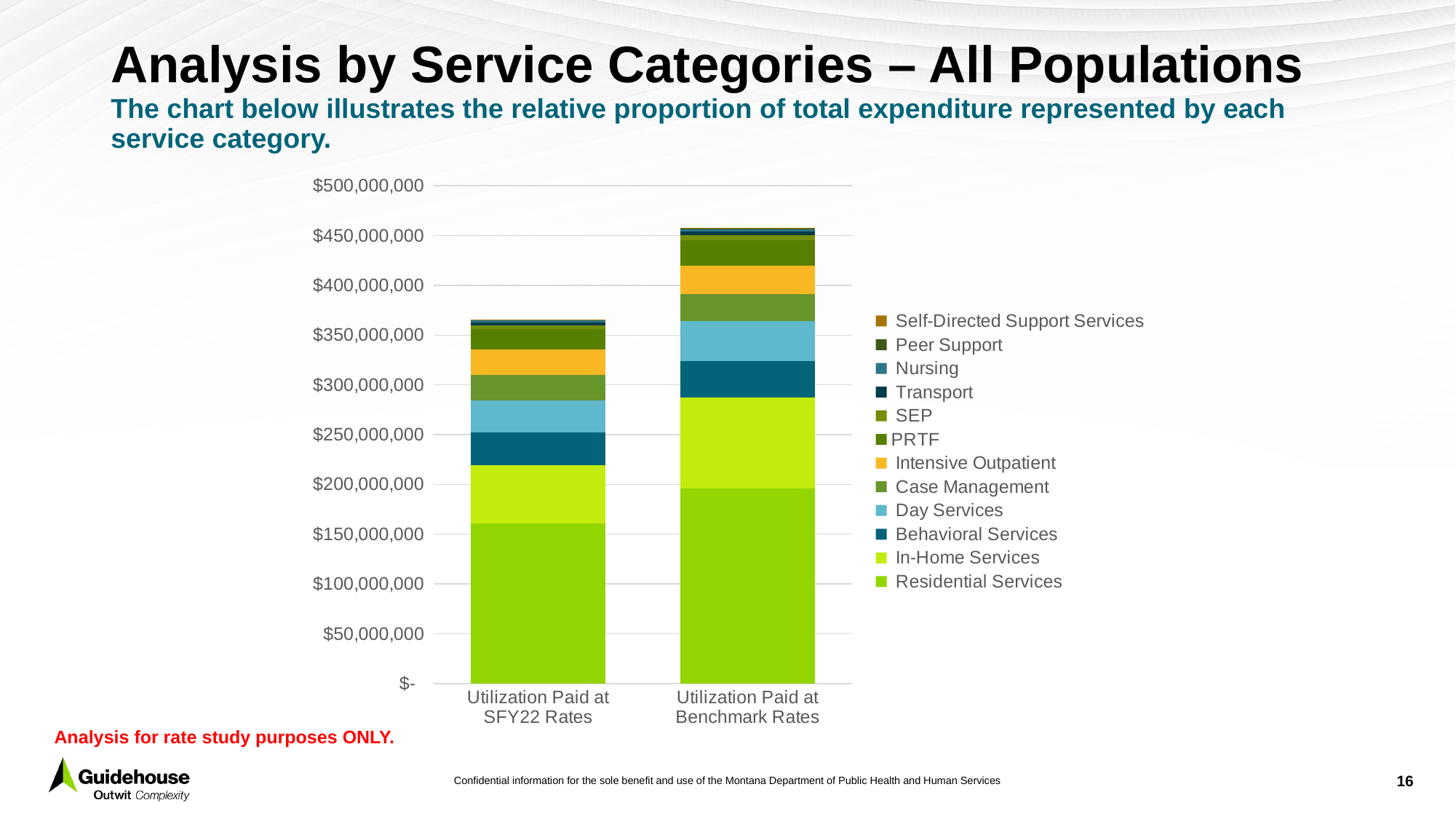
Is the total for Utilization Paid at SFY22 Rates greater or less than $400,000,000? less How many series does the legend list? 12 Is the total for Utilization Paid at Benchmark Rates greater or less than $500,000,000? less Is the total for Utilization Paid at Benchmark Rates greater or less than $400,000,000? greater Which series is listed first (at the top) in the legend? Self-Directed Support Services Which bar is taller in total: Utilization Paid at SFY22 Rates or Utilization Paid at Benchmark Rates? Utilization Paid at Benchmark Rates Which service category is the largest segment in both bars? Residential Services What kind of chart is shown on the slide? Stacked bar chart How many bars (categories) are plotted on the x axis? 2 What is the label of the second bar on the x axis? Utilization Paid at Benchmark Rates